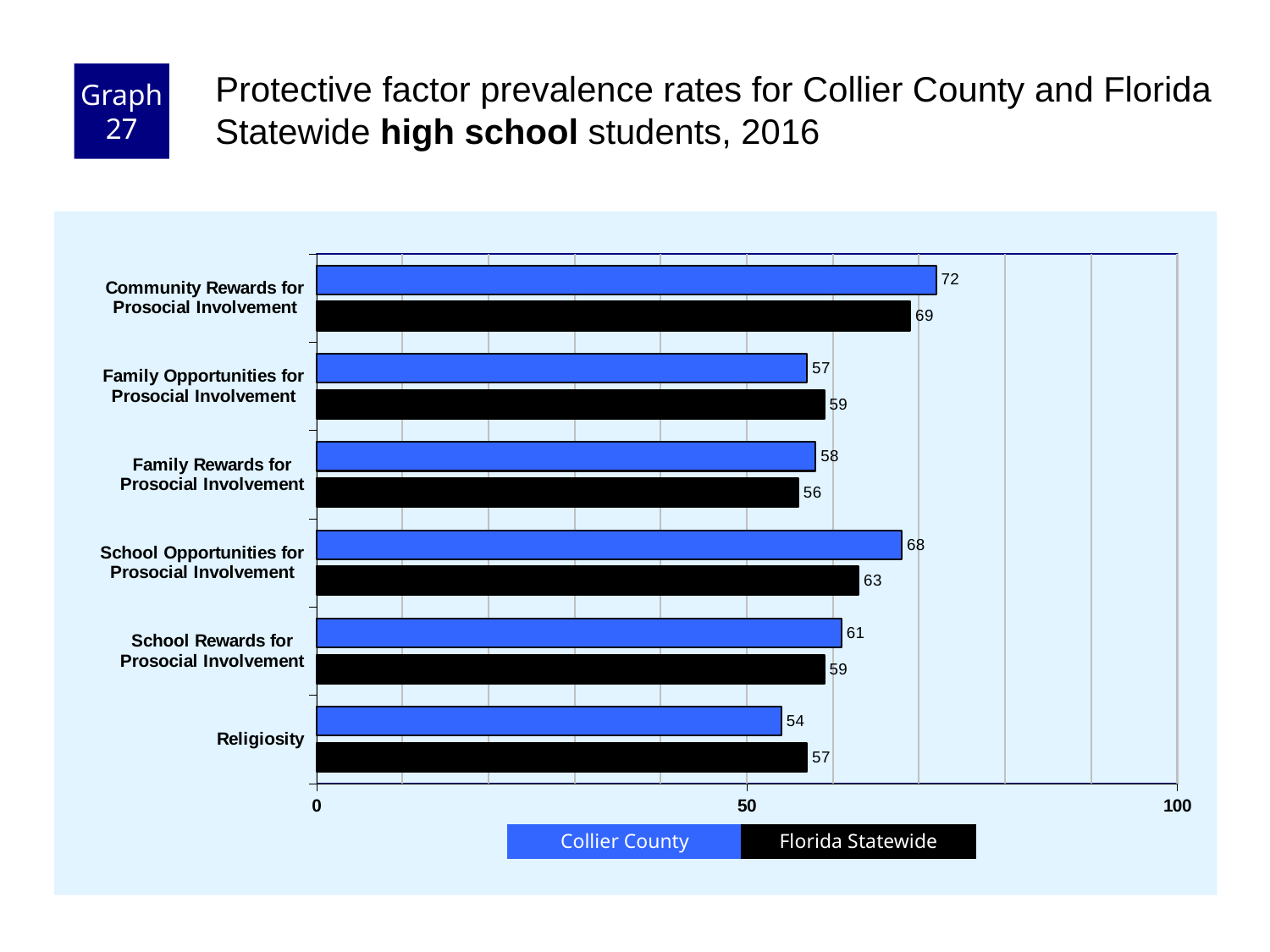
Which category has the lowest Collier County value? Religiosity What is the difference between the Collier County and Florida Statewide values for School Opportunities for Prosocial Involvement? 5 How many categories are shown on the chart? 6 Which category has the highest Collier County value? Community Rewards for Prosocial Involvement Which colour represents Florida Statewide in the chart? Black How many series does the legend list? 2 What is the Florida Statewide value for Religiosity? 57 What is the Collier County value for Community Rewards for Prosocial Involvement? 72 What is the Florida Statewide value for School Opportunities for Prosocial Involvement? 63 Which is larger for Family Opportunities for Prosocial Involvement: the Collier County value or the Florida Statewide value? Florida Statewide Is the Collier County value for Religiosity greater or less than 50? greater What kind of chart is shown on the slide? Bar chart